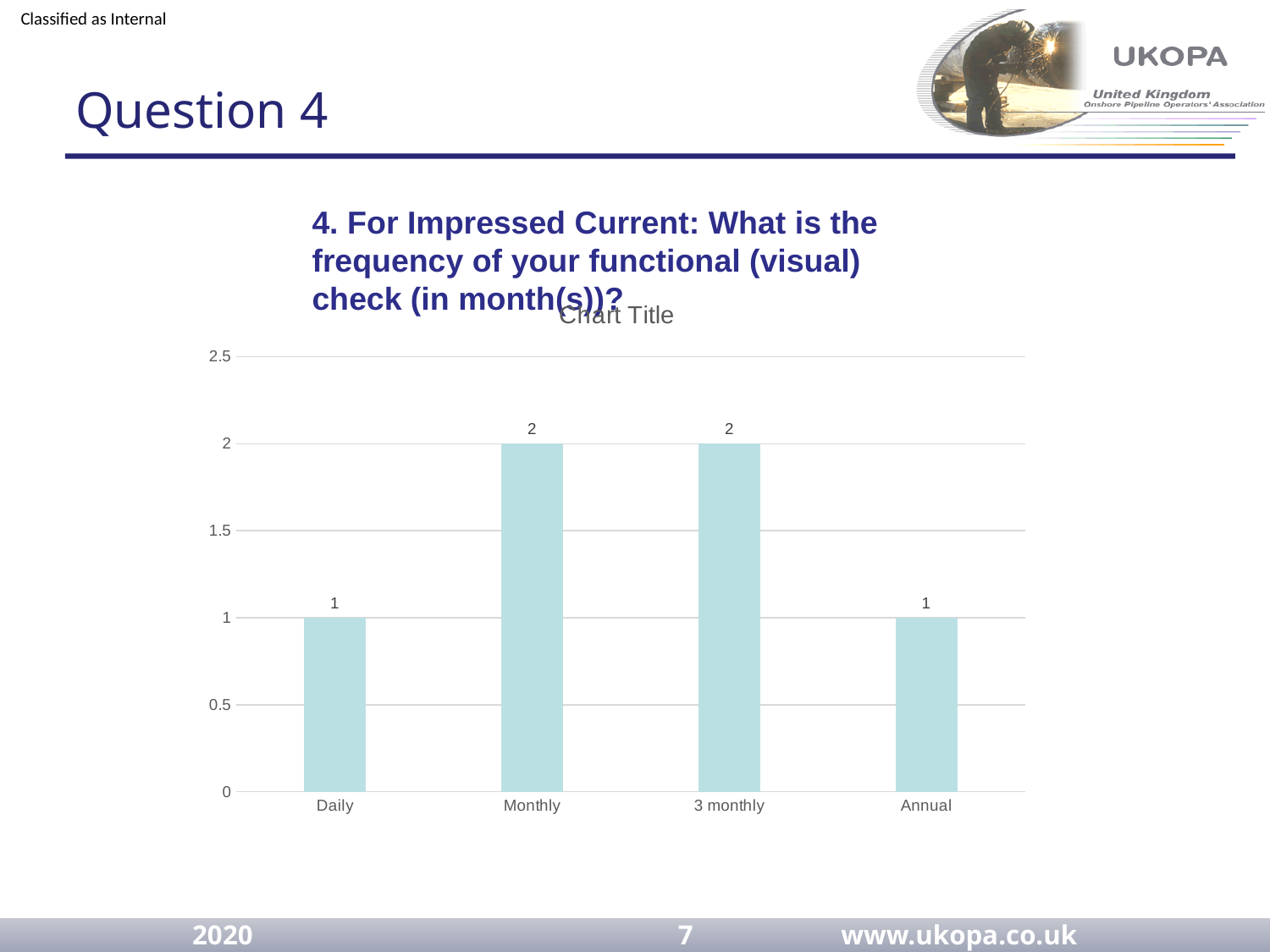
How many categories are shown on the x axis? 4 What is the value for Monthly? 2 Is the value for Monthly greater or less than 1.5? greater Which categories have the highest value? Monthly and 3 monthly What is the difference between the values for Monthly and Daily? 1 Which is larger, the value for 3 monthly or the value for Annual? 3 monthly What is the value for 3 monthly? 2 Which categories have the lowest value? Daily and Annual What is the title printed above the chart? Chart Title What kind of chart is shown on the slide? Bar chart What is the value for Daily? 1 What is the value for Annual? 1